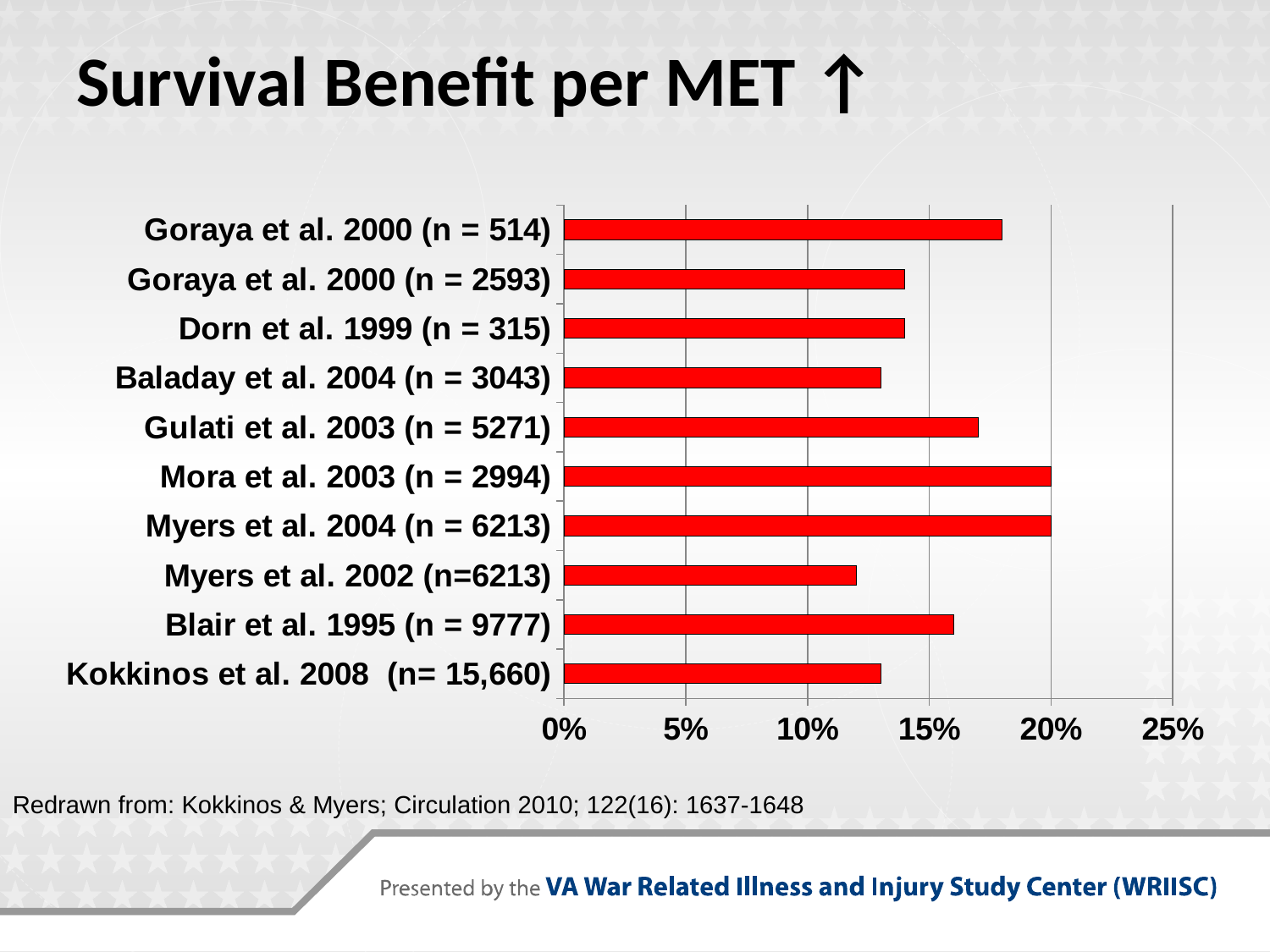
How many studies (categories) are plotted in the chart? 10 Is the value for Goraya et al. 2000 (n = 514) greater or less than 15%? greater Is the value for Baladay et al. 2004 (n = 3043) greater or less than 15%? less What is the title of the chart on the slide? Survival Benefit per MET ↑ Which has the larger value: Blair et al. 1995 (n = 9777) or Kokkinos et al. 2008 (n= 15,660)? Blair et al. 1995 (n = 9777) What is the value for Mora et al. 2003 (n = 2994)? 20% What is the value for Myers et al. 2004 (n = 6213)? 20% What kind of chart is shown on the slide? bar chart Is the value for Myers et al. 2002 (n=6213) greater or less than 10%? greater What colour are the bars in the chart? red Which has the larger value: Goraya et al. 2000 (n = 514) or Goraya et al. 2000 (n = 2593)? Goraya et al. 2000 (n = 514)